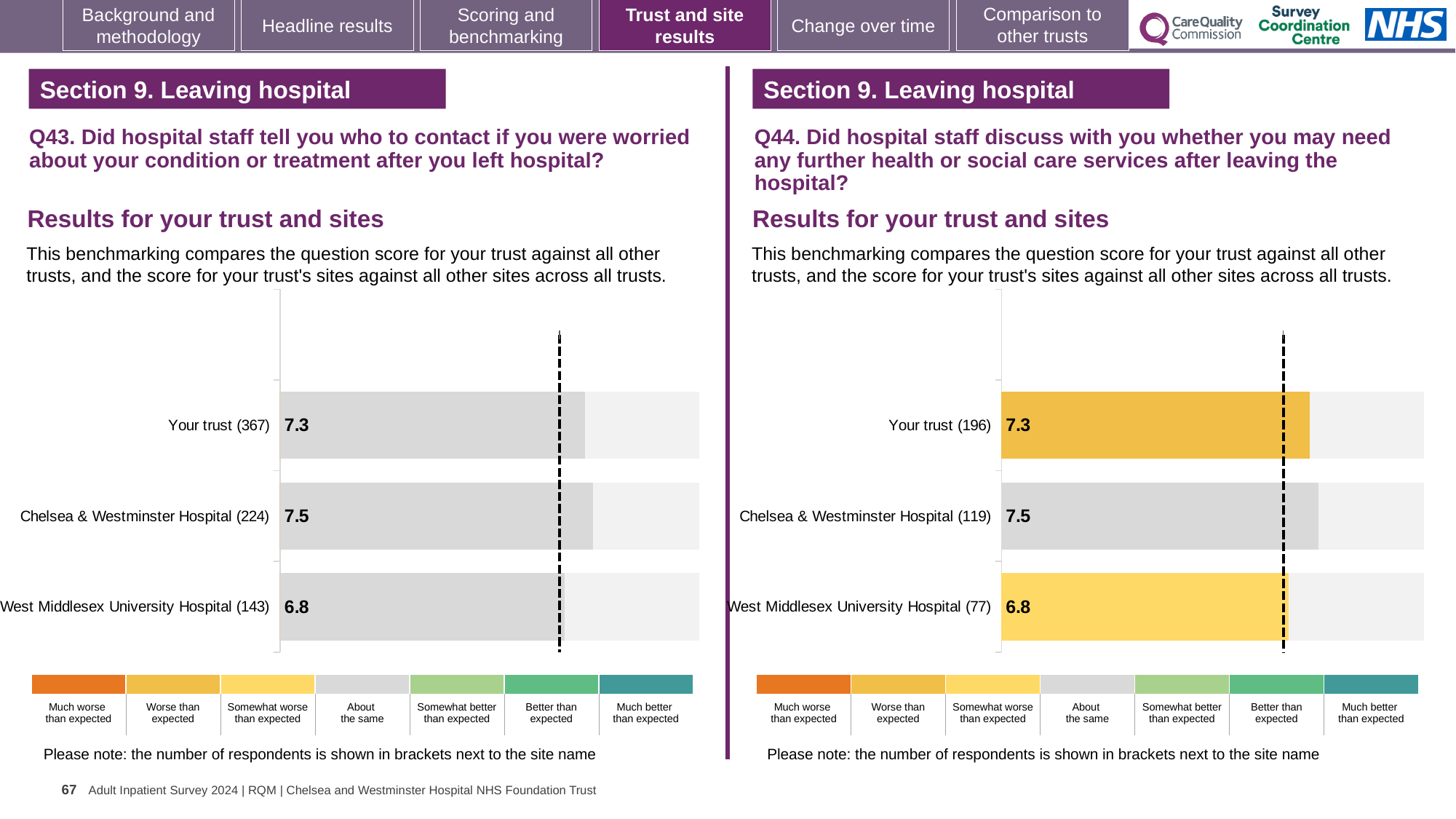
How many bars are plotted on the Q43 chart (left)? 3 On the Q43 chart (left), which site or trust has the highest score? Chelsea & Westminster Hospital On the Q44 chart (right), which site or trust has the lowest score? West Middlesex University Hospital On the Q44 chart (right), how many respondents are shown in brackets for West Middlesex University Hospital? 77 On the Q43 chart (left), what is the difference between the scores for Chelsea & Westminster Hospital and West Middlesex University Hospital? 0.7 On the Q43 chart (left), what is the score for Your trust? 7.3 On the Q44 chart (right), what is the difference between the scores for Your trust and West Middlesex University Hospital? 0.5 On the Q44 chart (right), which has the larger score, Your trust or Chelsea & Westminster Hospital? Chelsea & Westminster Hospital On the Q44 chart (right), what is the score for Chelsea & Westminster Hospital? 7.5 On the Q43 chart (left), how many respondents are shown in brackets for Your trust? 367 On the Q43 chart (left), what is the score for West Middlesex University Hospital? 6.8 What type of chart is used on the Q44 chart (right)? Bar chart